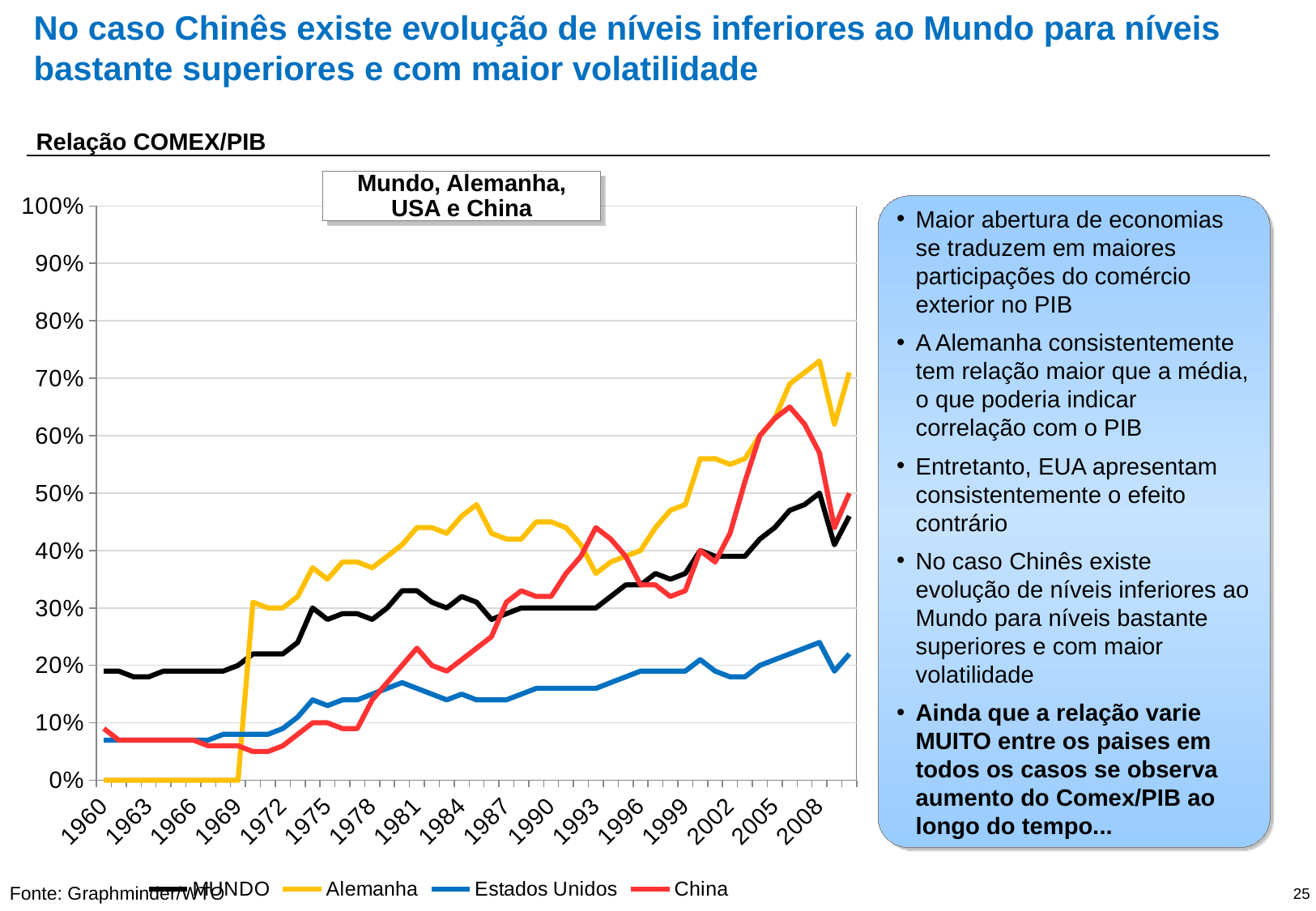
What is the title shown inside the chart area? Mundo, Alemanha, USA e China Does the Estados Unidos line generally rise or fall from 1960 to 2008? rise Is the value for Alemanha in 1960 greater or less than 10%? less Is the value for Estados Unidos in 2008 greater or less than 30%? less What kind of chart is shown on the slide? line chart Which colour is used for the China line in the chart? red Which series has the lowest value in 2008? Estados Unidos In 2005, which series has the higher value: Alemanha or Estados Unidos? Alemanha Is the value for Alemanha in 2008 greater or less than 60%? greater How many series does the chart legend list? 4